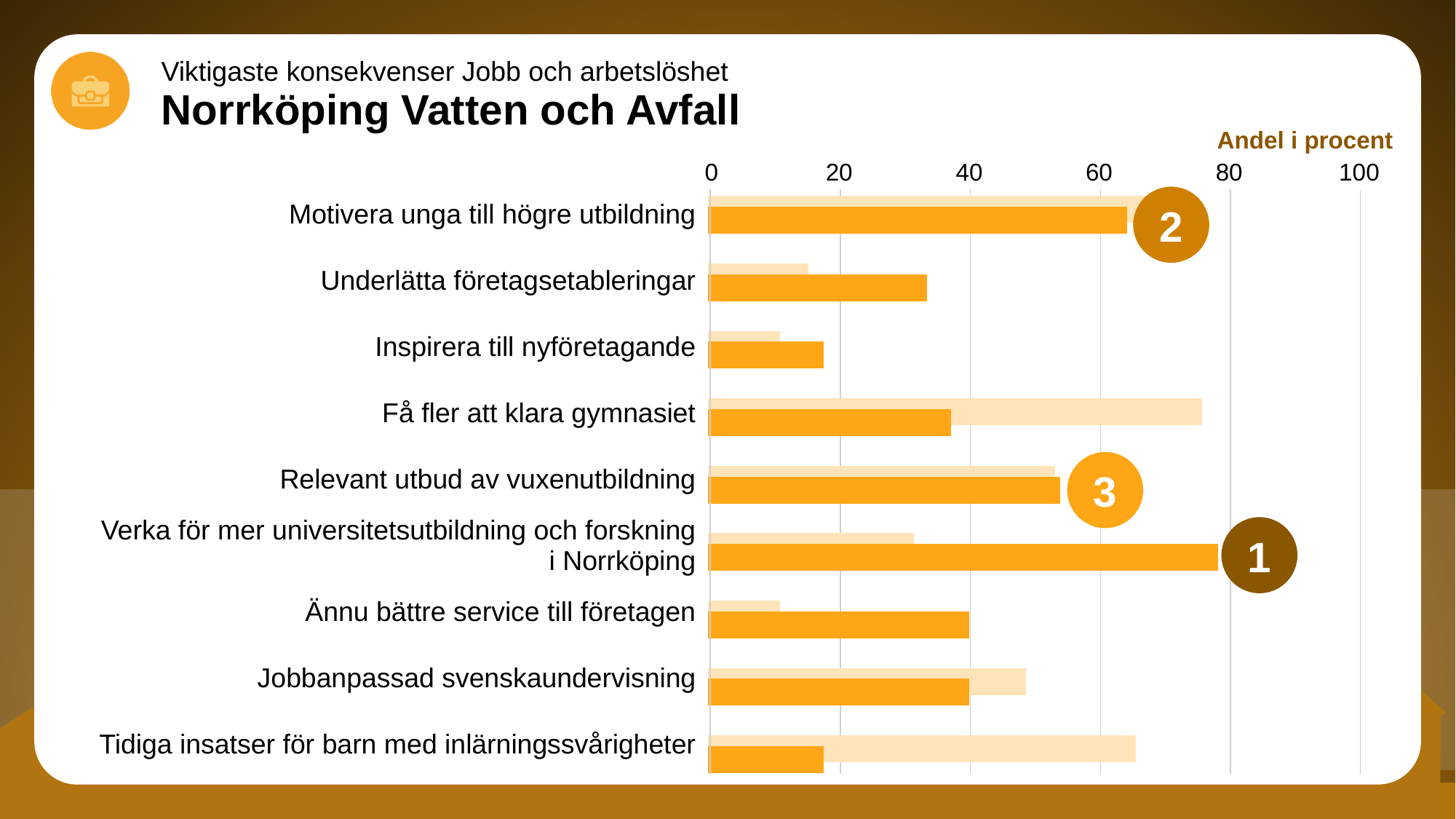
Which is larger for Få fler att klara gymnasiet, the dark orange bar or the light orange bar? the light orange bar Is the dark orange bar for Relevant utbud av vuxenutbildning greater or less than 40? greater Is the light orange bar for Underlätta företagsetableringar greater or less than 20? less Which dark orange bar is longer, Motivera unga till högre utbildning or Underlätta företagsetableringar? Motivera unga till högre utbildning Which category is marked with the circle labelled 1? Verka för mer universitetsutbildning och forskning i Norrköping How many categories are listed on the chart? 9 Is the dark orange bar for Inspirera till nyföretagande greater or less than 20? less What kind of chart is shown on the slide? bar chart What label is shown above the horizontal axis of the chart? Andel i procent Which category has the longest dark orange bar? Verka för mer universitetsutbildning och forskning i Norrköping Which category has the longest light orange bar? Få fler att klara gymnasiet